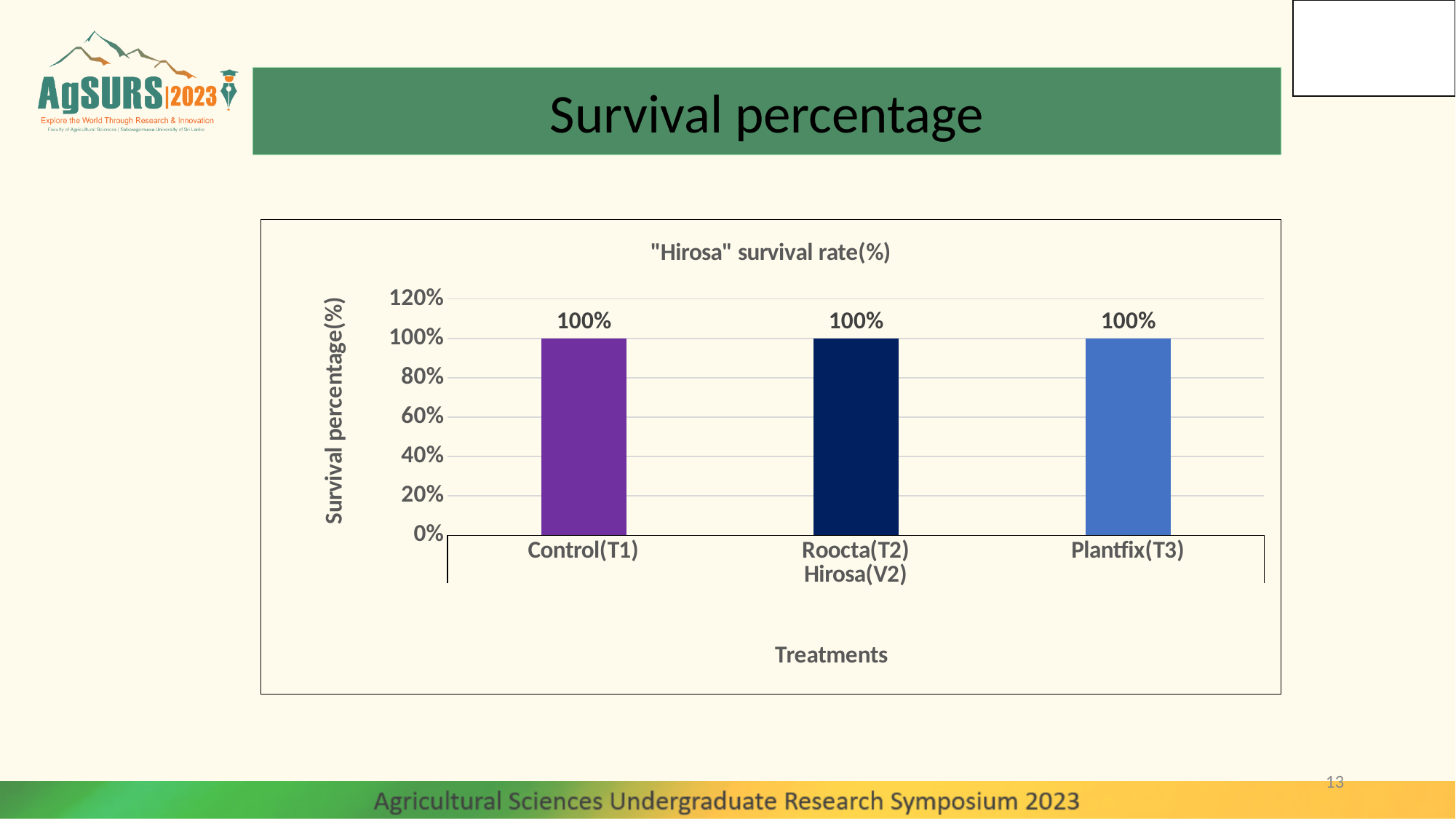
Is the survival rate for Roocta(T2) greater or less than 80%? greater Do the survival rates rise, fall, or stay the same across the treatments from left to right? stay the same What is the label of the x axis? Treatments What kind of chart is shown on the slide? bar chart What is the difference between the survival rates of Control(T1) and Plantfix(T3)? 0% What is the title of the chart? "Hirosa" survival rate(%) What is the survival rate for Roocta(T2)? 100% Is the survival rate for Control(T1) greater or less than 120%? less What is the survival rate for Control(T1)? 100% How many treatments are shown in the chart? 3 What is the survival rate for Plantfix(T3)? 100%